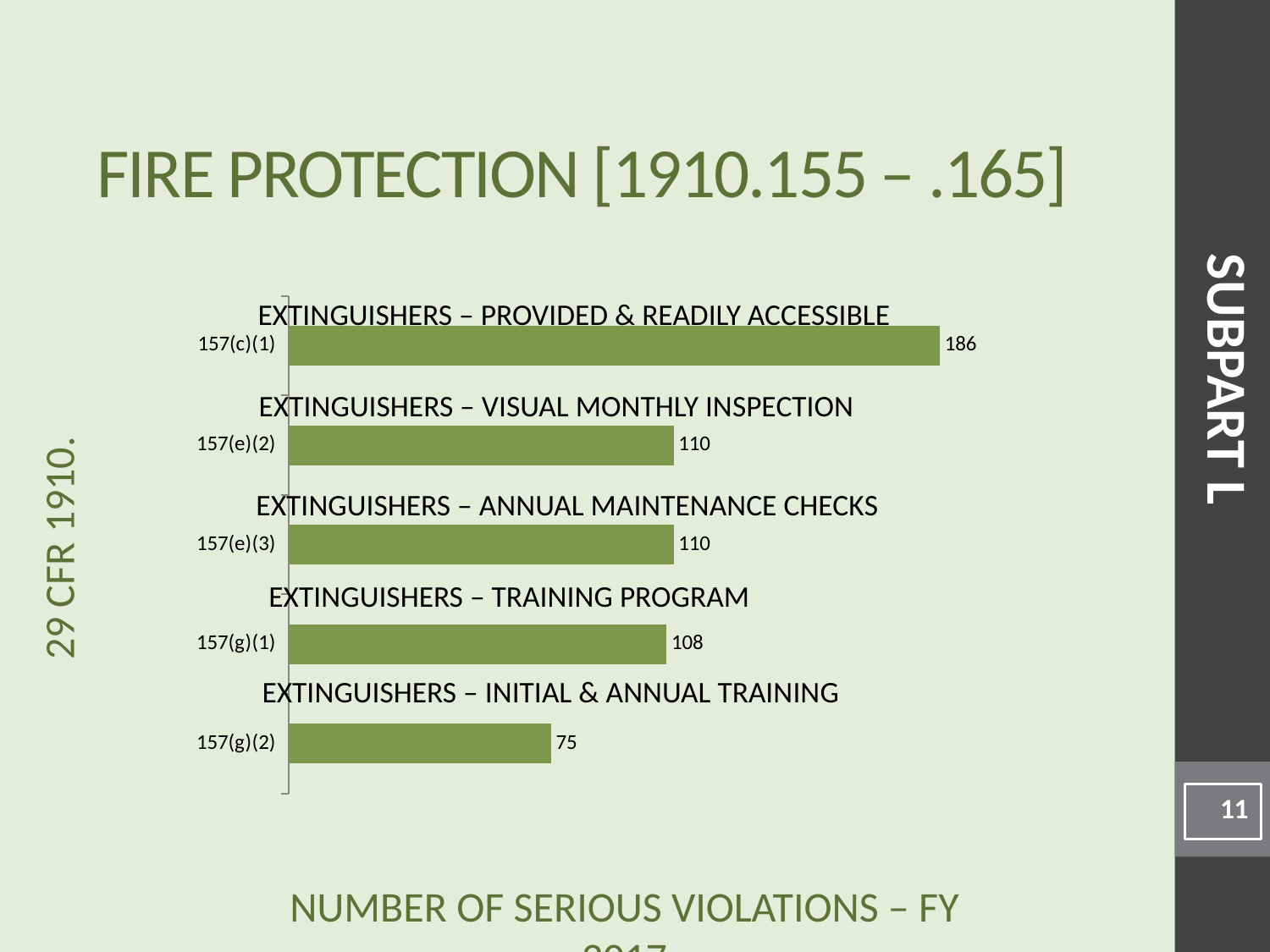
What is the difference between the values for 157(e)(3) and 157(g)(1)? 2 What is the value shown for 157(e)(2)? 110 Which category has the lowest number of serious violations? 157(g)(2) What kind of chart is shown on the slide? Bar chart What is the number of serious violations for 157(g)(2)? 75 Which category has the highest number of serious violations? 157(c)(1) Which is larger, the value for 157(c)(1) or the value for 157(e)(2)? 157(c)(1) What is the number of serious violations for 157(c)(1)? 186 How many categories are plotted in the chart? 5 What is the difference between the values for 157(c)(1) and 157(g)(2)? 111 What is the value shown for 157(g)(1)? 108 What is the title of the slide containing the chart? FIRE PROTECTION [1910.155 – .165]